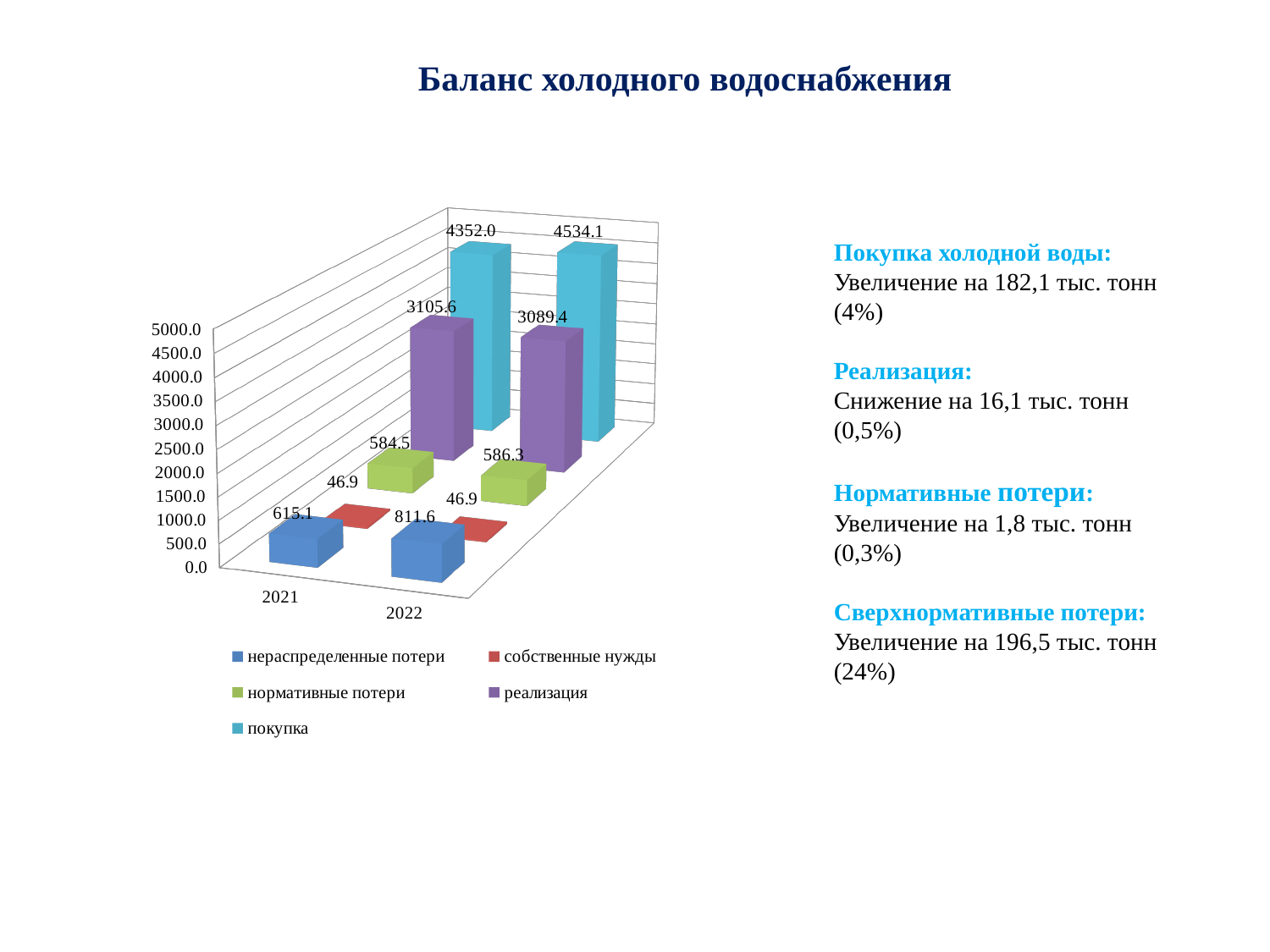
What is the value of реализация for 2021? 3105.6 What is the value of покупка for 2022? 4534.1 Which series has the highest value in 2022? покупка How many series does the legend list? 5 Which is larger, реализация in 2021 or реализация in 2022? реализация in 2021 How many categories are shown on the x axis? 2 What is the value of собственные нужды for 2022? 46.9 What kind of chart is shown on the slide? bar chart Which series has the lowest value in 2021? собственные нужды What is the value of нормативные потери for 2021? 584.5 What is the difference between the покупка values for 2022 and 2021? 182.1 What is the value of нераспределенные потери for 2022? 811.6